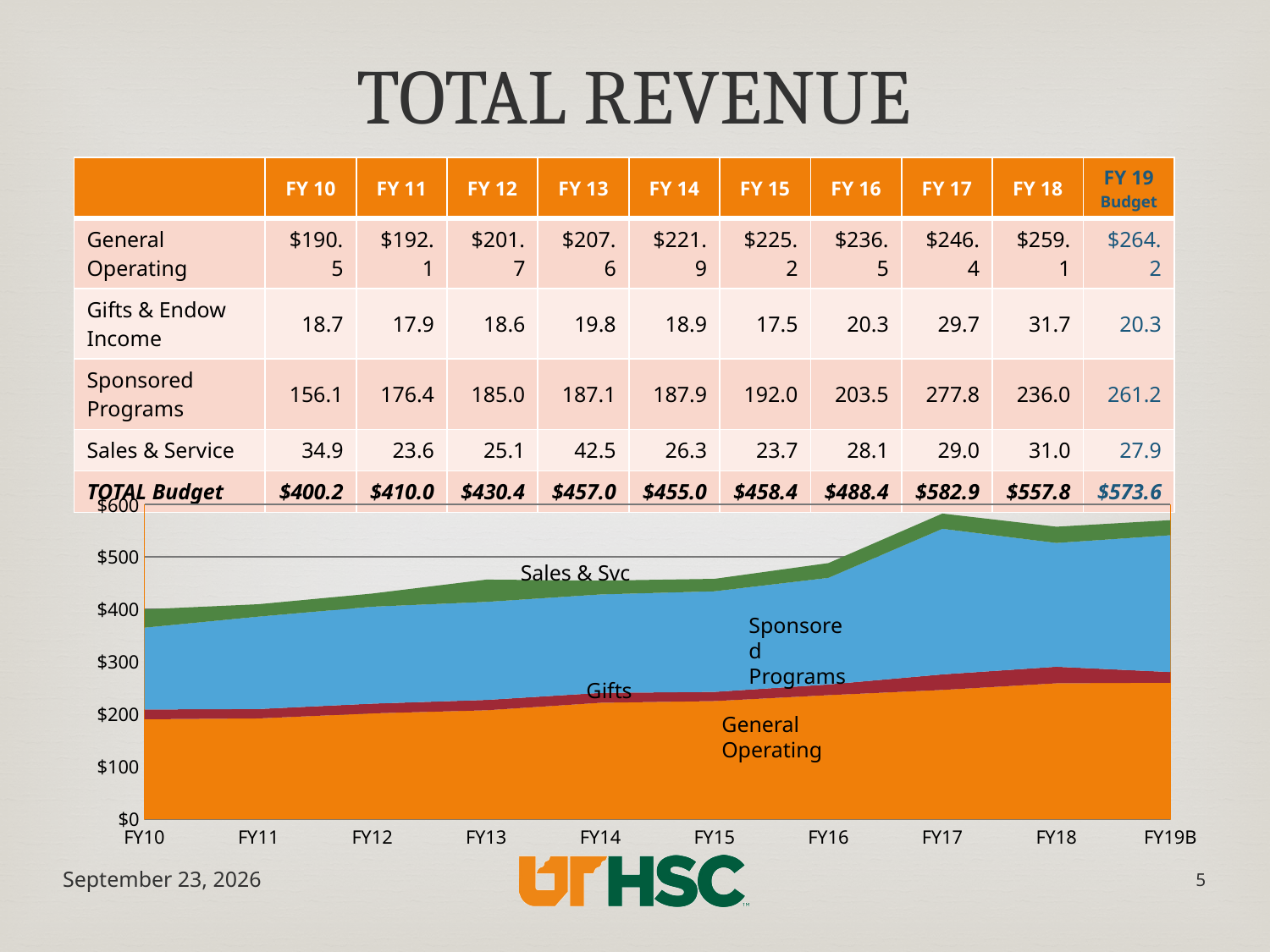
What kind of chart is shown at the bottom of the slide? Stacked area chart Which category forms the top (green) layer of the stacked area chart? Sales & Svc How many fiscal-year points are plotted along the x axis of the area chart? 10 According to the table, what is the TOTAL Budget for FY 17? $582.9 How many revenue categories are stacked in the area chart? 4 Which category forms the bottom (orange) layer of the stacked area chart? General Operating Is the total revenue plotted for FY17 greater or less than $500? greater In which fiscal year does the stacked total reach its highest point? FY17 Is the General Operating value plotted for FY18 greater or less than $200? greater Does the total revenue generally rise or fall from FY10 to FY17? rise Is the total revenue plotted for FY10 greater or less than $500? less In which fiscal year is the stacked total at its lowest? FY10